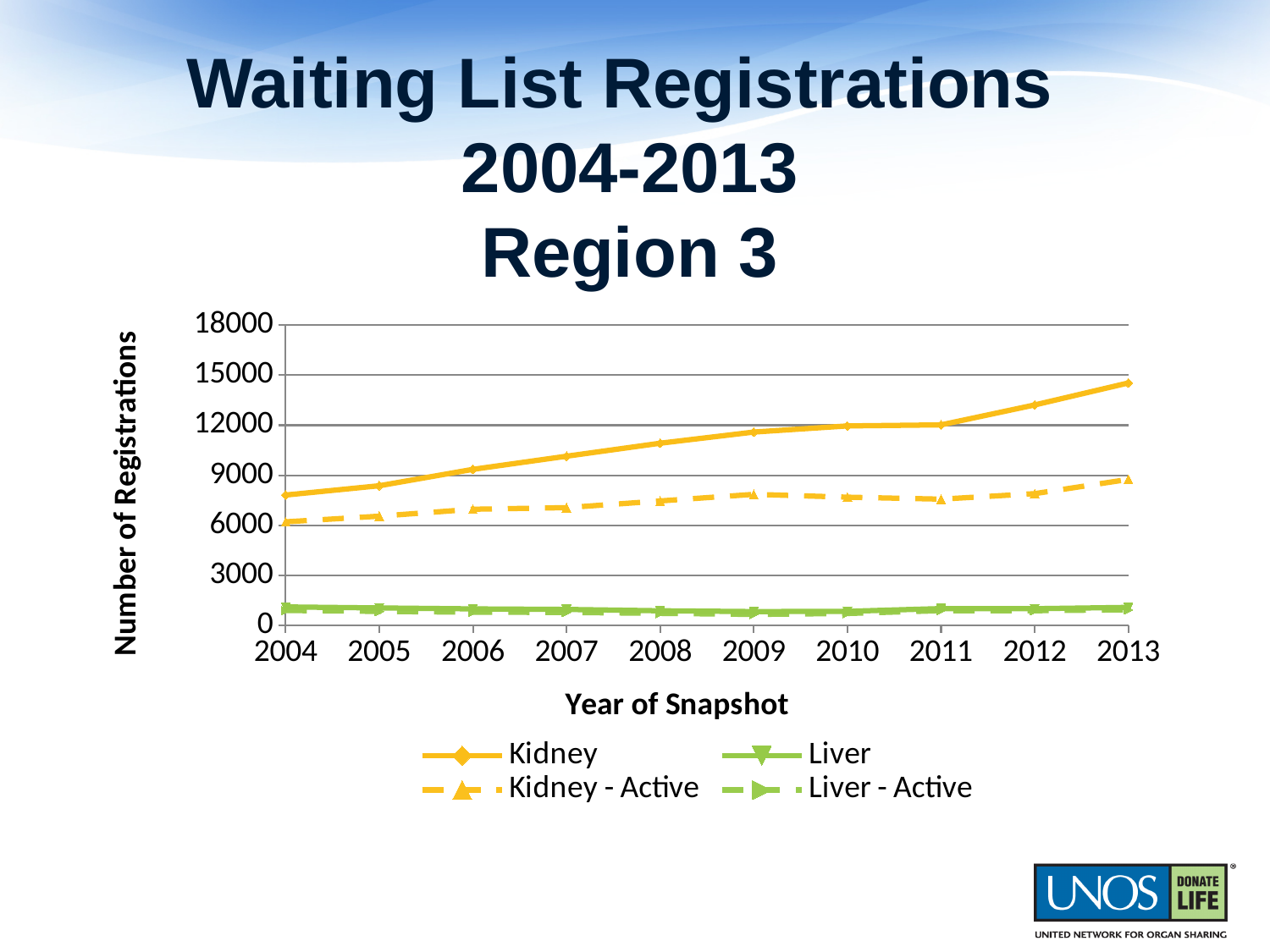
What kind of chart is shown on the slide? line chart Is the Kidney value for 2013 greater or less than 12000? greater Is the Liver value for 2010 greater or less than 3000? less In which year is the Kidney series at its highest? 2013 What is the title of the x axis? Year of Snapshot Is the Kidney - Active value for 2013 greater or less than 6000? greater How many years are plotted along the x axis? 10 Does the Kidney series rise or fall from 2004 to 2013? rise How many series does the legend list? 4 Which series has the highest values across the chart? Kidney In 2013, which is larger: Kidney or Kidney - Active? Kidney